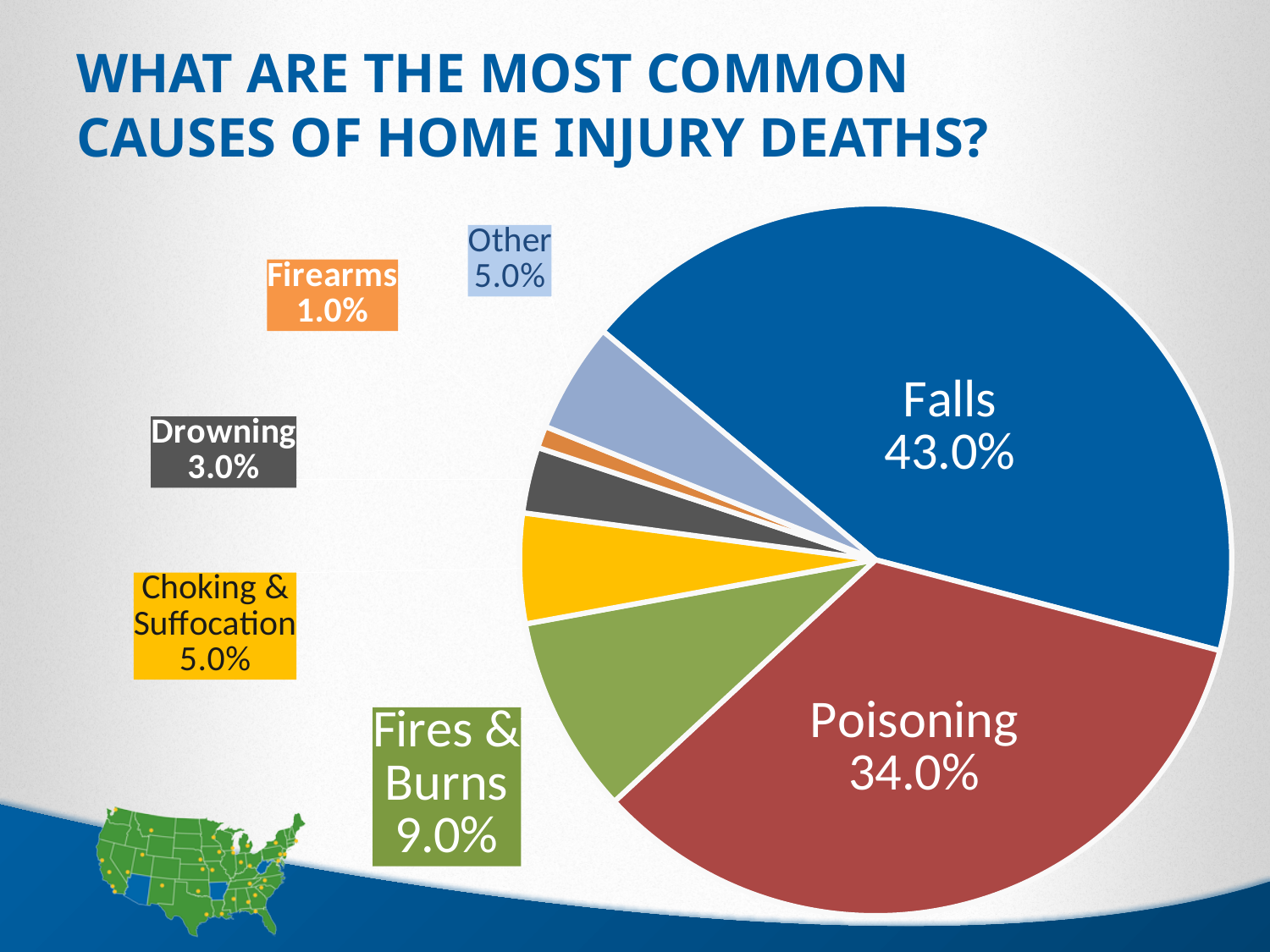
What percentage of home injury deaths is due to Poisoning? 34.0% What percentage is shown for Drowning? 3.0% What is the value for Firearms? 1.0% What type of chart is shown on the slide? Pie chart Which is larger, the share for Fires & Burns or the share for Drowning? Fires & Burns What is the value shown for Fires & Burns? 9.0% What colour is the Poisoning slice? Red Which cause has the smallest slice of the pie? Firearms What share of home injury deaths is attributed to Falls? 43.0% How many categories are shown in the pie chart? 7 What is the difference in percentage points between Falls and Poisoning? 9.0% Which cause of home injury deaths has the largest slice of the pie? Falls